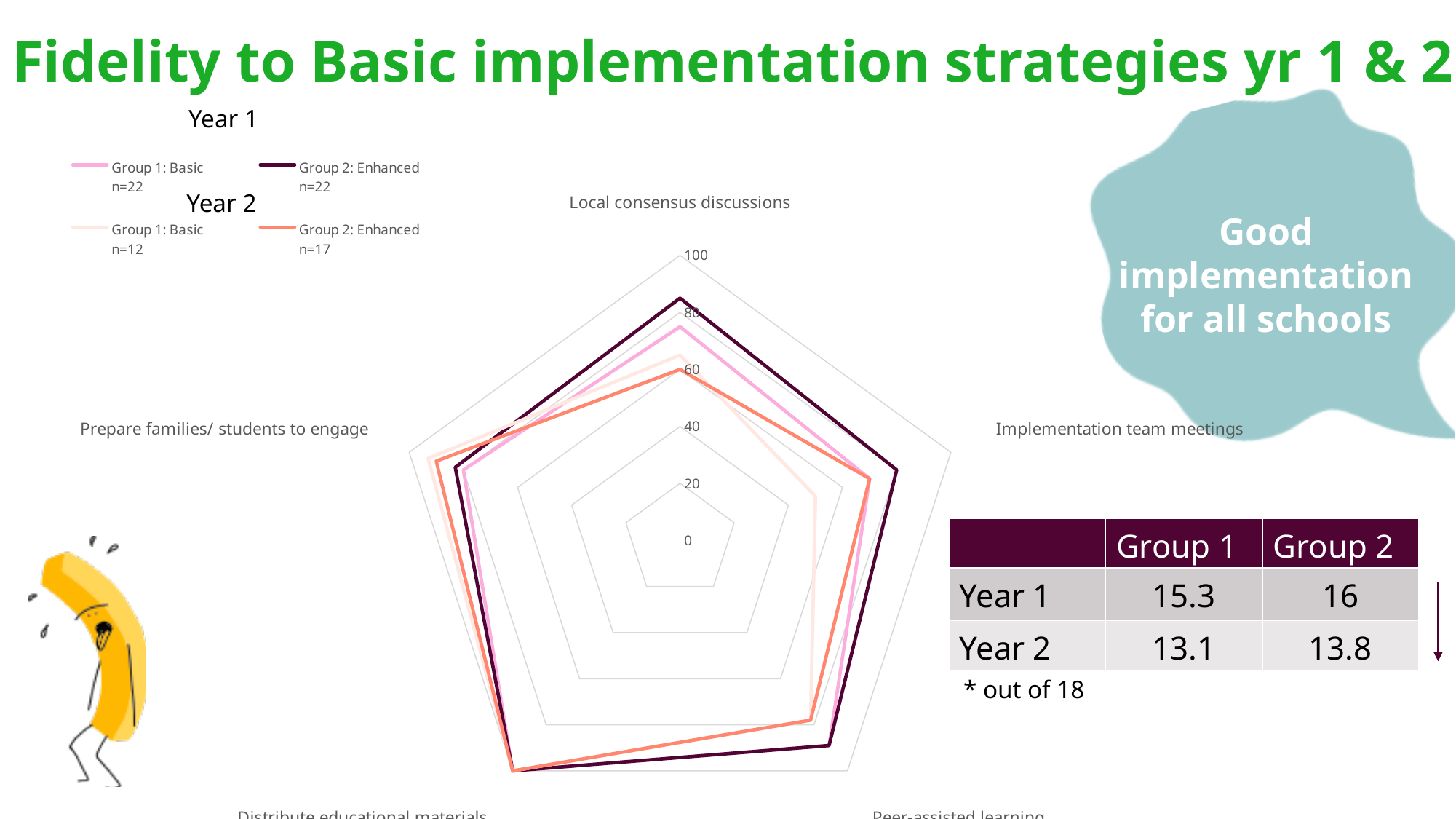
Is the value for Local consensus discussions for Year 1 Group 2: Enhanced (n=22) greater or less than 80? greater What kind of chart is shown on the slide? Radar chart For Implementation team meetings, which is higher: Year 1 Group 2: Enhanced (n=22) or Year 2 Group 1: Basic (n=12)? Year 1 Group 2: Enhanced (n=22) How many series does the chart legend list? 4 How many implementation strategies (axes) does the radar chart have? 5 Is the value for Implementation team meetings for Year 2 Group 1: Basic (n=12) greater or less than 60? less Is the value for Local consensus discussions for Year 1 Group 1: Basic (n=22) greater or less than 80? less For Local consensus discussions, which is higher: Year 1 Group 2: Enhanced (n=22) or Year 2 Group 2: Enhanced (n=17)? Year 1 Group 2: Enhanced (n=22) What is the sample size (n) for the Year 2 Group 2: Enhanced series in the legend? n=17 What is the title of the slide containing the radar chart? Fidelity to Basic implementation strategies yr 1 & 2